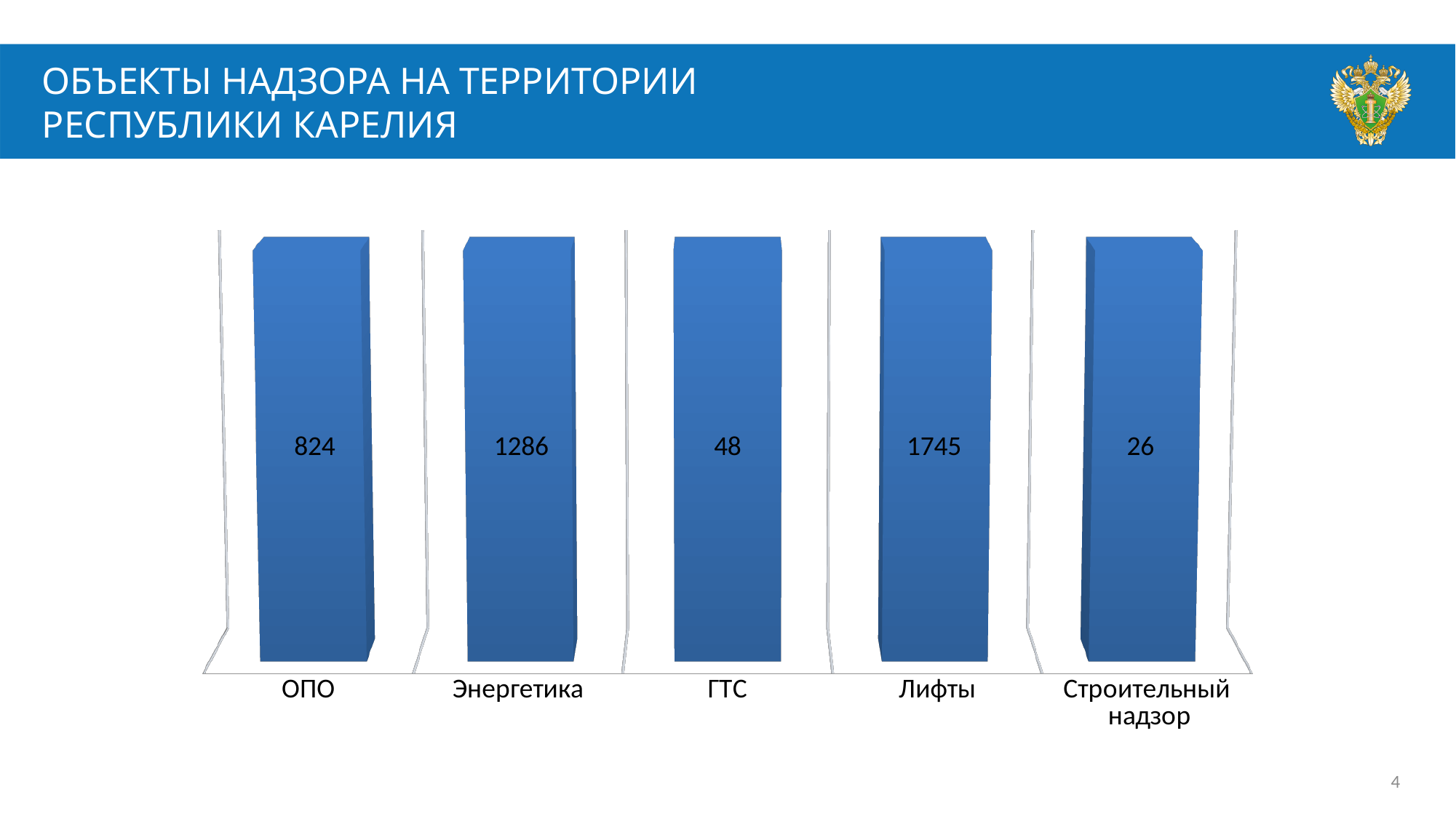
What is the value for ОПО? 824 What kind of chart is shown on the slide? Bar chart What is the value for Лифты? 1745 What is the difference between the values for ГТС and Строительный надзор? 22 What is the difference between the values for Лифты and Энергетика? 459 Which category has the highest value? Лифты What is the value for Энергетика? 1286 Which category has the lowest value? Строительный надзор What is the value for Строительный надзор? 26 What is the value for ГТС? 48 Which is larger, the value for ОПО or the value for Энергетика? Энергетика How many categories are shown in the chart? 5